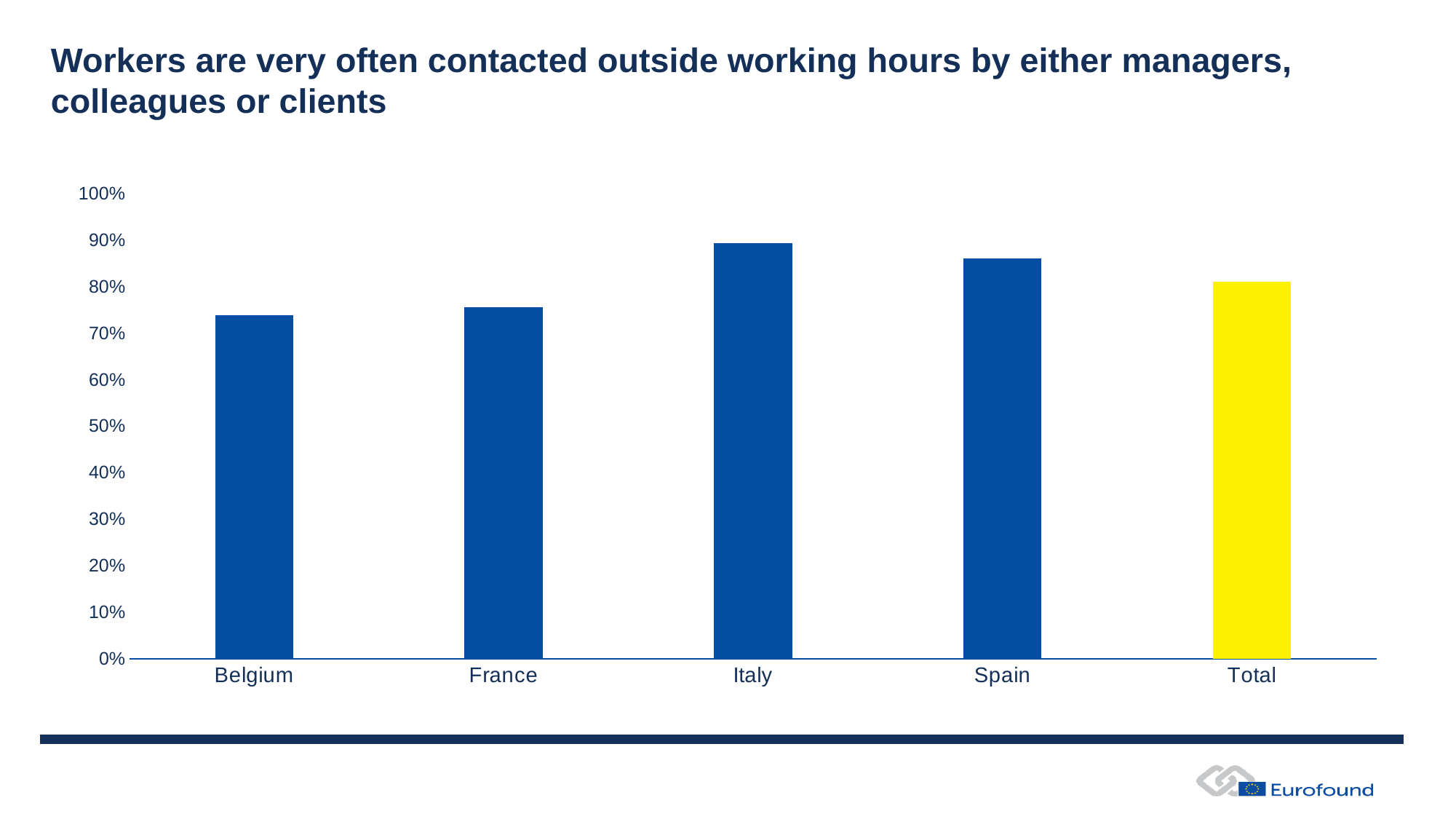
Which is larger, the value for Spain or the value for France? Spain Is the value for Spain greater or less than 90%? less How many categories are shown on the x axis of the chart? 5 Which category has the highest value in the chart? Italy What kind of chart is shown on the slide? bar chart Is the value for France greater or less than 80%? less Is the value for Total greater or less than 90%? less Which bar in the chart is coloured yellow rather than blue? Total Which is larger, the value for Italy or the value for Belgium? Italy